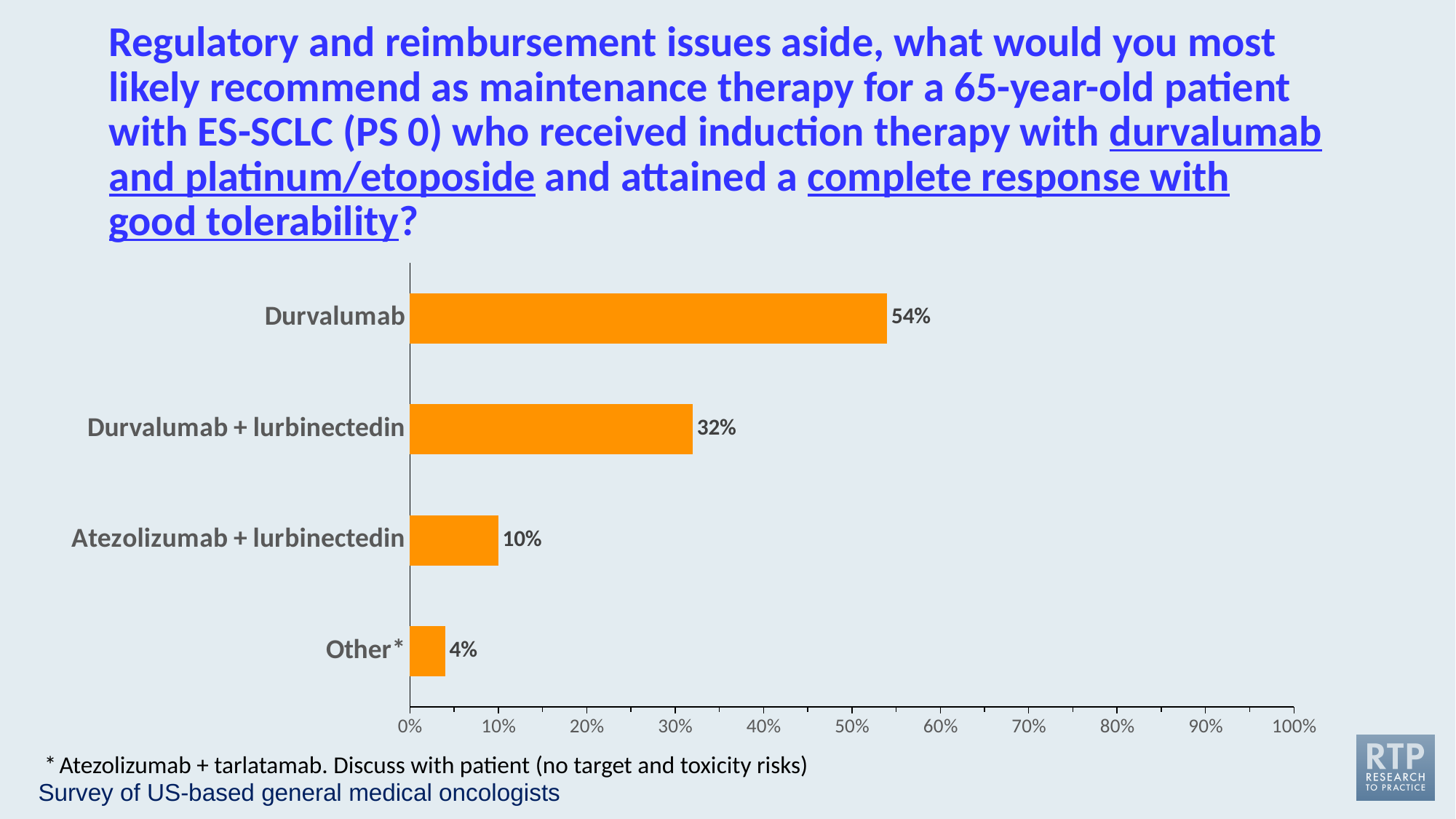
What percentage of respondents chose Other*? 4% Which option received the lowest percentage of responses? Other* What is the maximum value shown on the horizontal axis? 100% How many response options are shown in the chart? 4 Which received a larger share of responses, Durvalumab + lurbinectedin or Atezolizumab + lurbinectedin? Durvalumab + lurbinectedin What type of chart is shown on the slide? Bar chart Is the value for Durvalumab greater or less than 50%? greater What percentage of respondents chose Durvalumab as maintenance therapy? 54% What percentage of respondents chose Durvalumab + lurbinectedin? 32% What percentage of respondents chose Atezolizumab + lurbinectedin? 10% What is the difference in percentage points between Durvalumab and Durvalumab + lurbinectedin? 22 percentage points Which option received the highest percentage of responses? Durvalumab